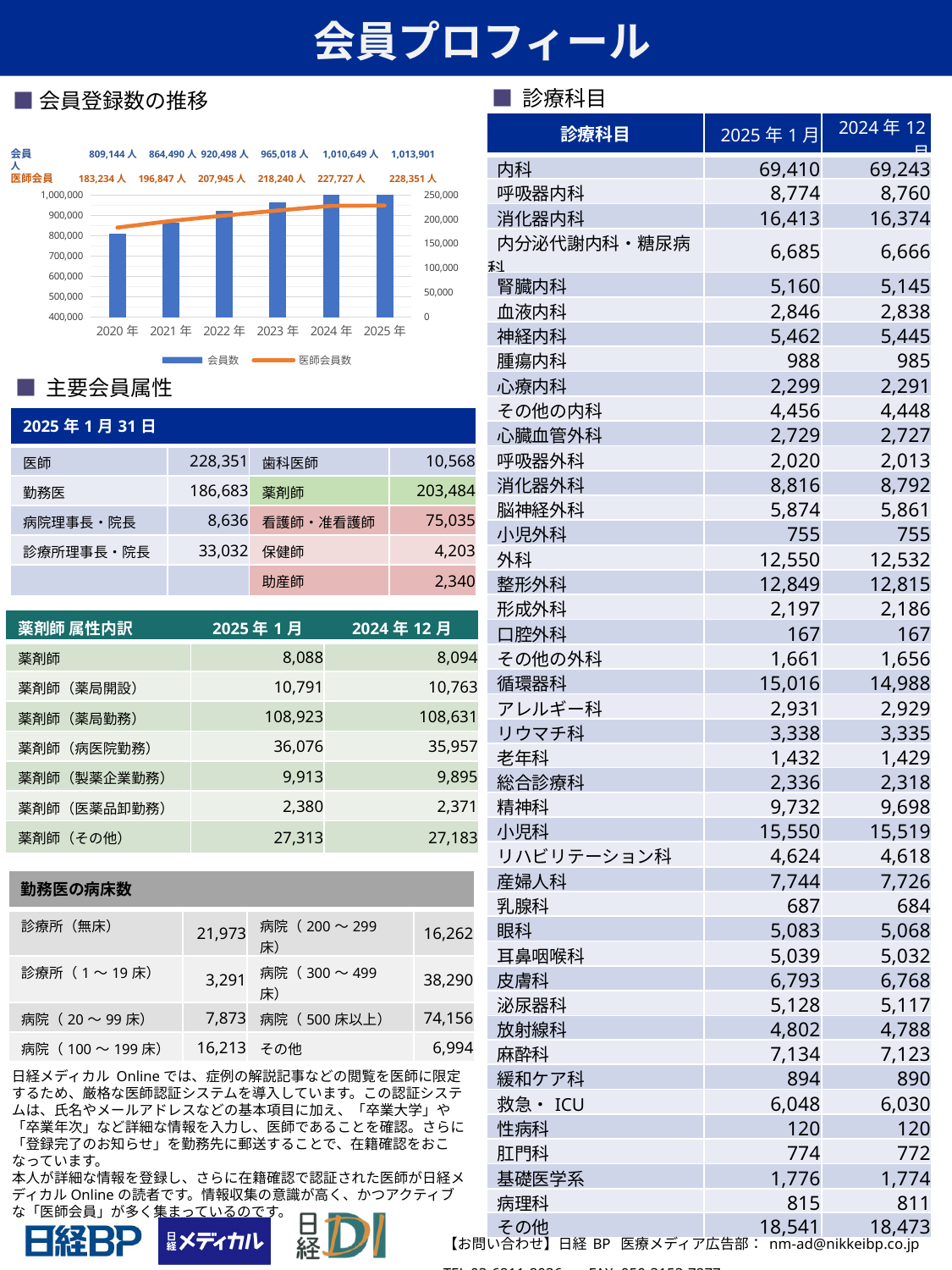
In the 会員登録数の推移 chart, is the 会員数 bar for 2020年 greater or less than 900,000? less In the 会員登録数の推移 chart, which year has the highest 会員数? 2025年 In the 会員登録数の推移 chart, what is the 会員数 value for 2025年? 1,013,901 In the 会員登録数の推移 chart, what is the 医師会員数 value for 2023年? 218,240人 In the 会員登録数の推移 chart, what is the difference in 医師会員数 between 2025年 and 2020年? 45,117人 In the 会員登録数の推移 chart, which year has the lowest 医師会員数? 2020年 How many years are shown on the x axis of the 会員登録数の推移 chart? 6 In the 会員登録数の推移 chart, what is the difference in 会員数 between 2025年 and 2024年? 3,252 Do the 会員数 values in the 会員登録数の推移 chart rise or fall from 2020年 to 2025年? rise How many series does the legend of the 会員登録数の推移 chart list? 2 In the 会員登録数の推移 chart, what is the 会員数 value for 2020年? 809,144人 In the 会員登録数の推移 chart, which is larger, the 会員数 for 2022年 or for 2021年? 2022年